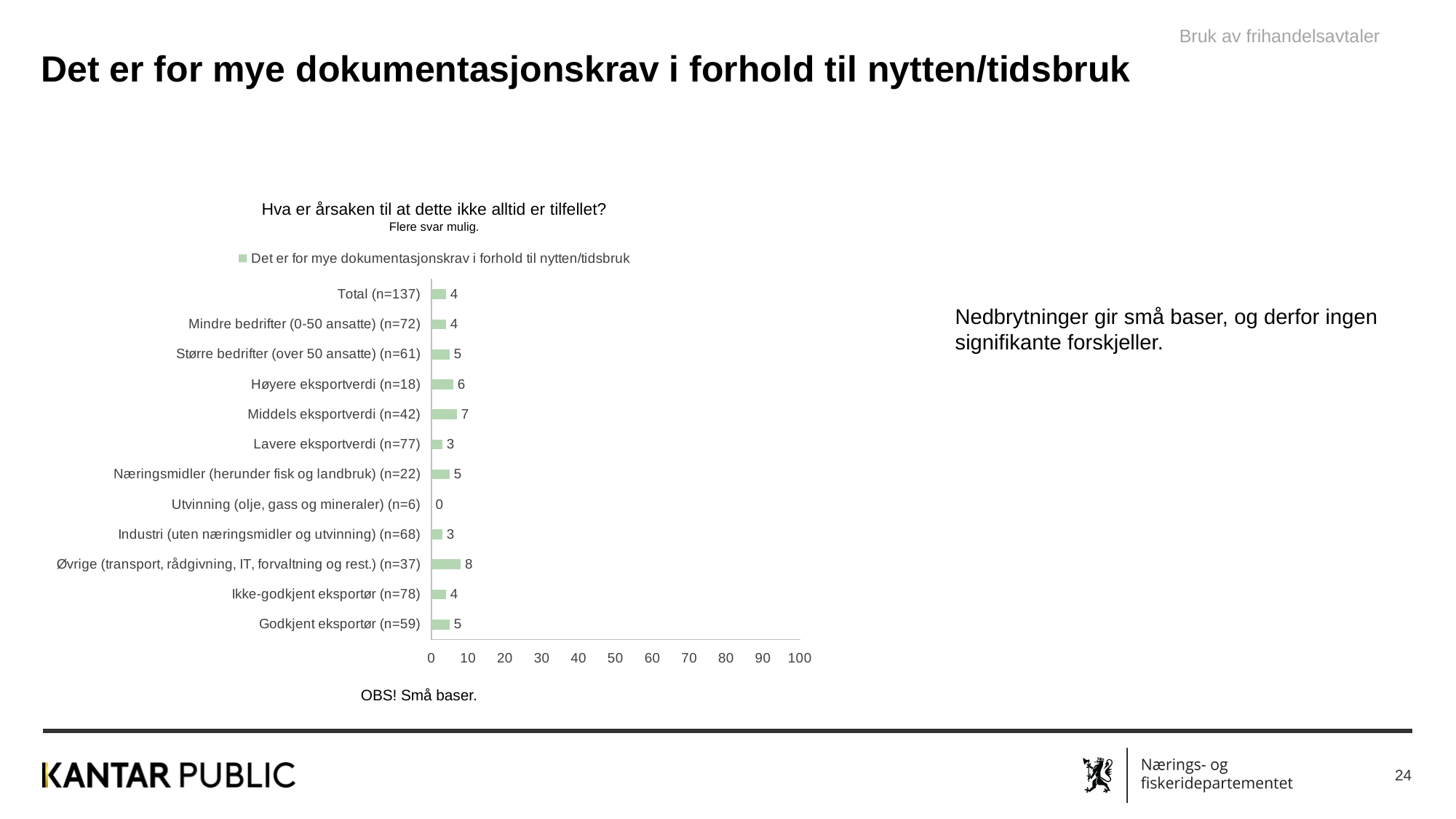
Which is larger, the value for Høyere eksportverdi (n=18) or the value for Industri (uten næringsmidler og utvinning) (n=68)? Høyere eksportverdi (n=18) Which category has the highest value? Øvrige (transport, rådgivning, IT, forvaltning og rest.) (n=37) What is the value for Middels eksportverdi (n=42)? 7 How many series does the legend list? 1 What kind of chart is shown on the slide? bar chart What is the value for Utvinning (olje, gass og mineraler) (n=6)? 0 Which category has the lowest value? Utvinning (olje, gass og mineraler) (n=6) Is the value for Godkjent eksportør (n=59) greater or less than 10? less What is the value for Total (n=137)? 4 How many categories are shown on the chart? 12 What is the series name shown in the legend? Det er for mye dokumentasjonskrav i forhold til nytten/tidsbruk What is the difference between the values for Øvrige (transport, rådgivning, IT, forvaltning og rest.) (n=37) and Lavere eksportverdi (n=77)? 5